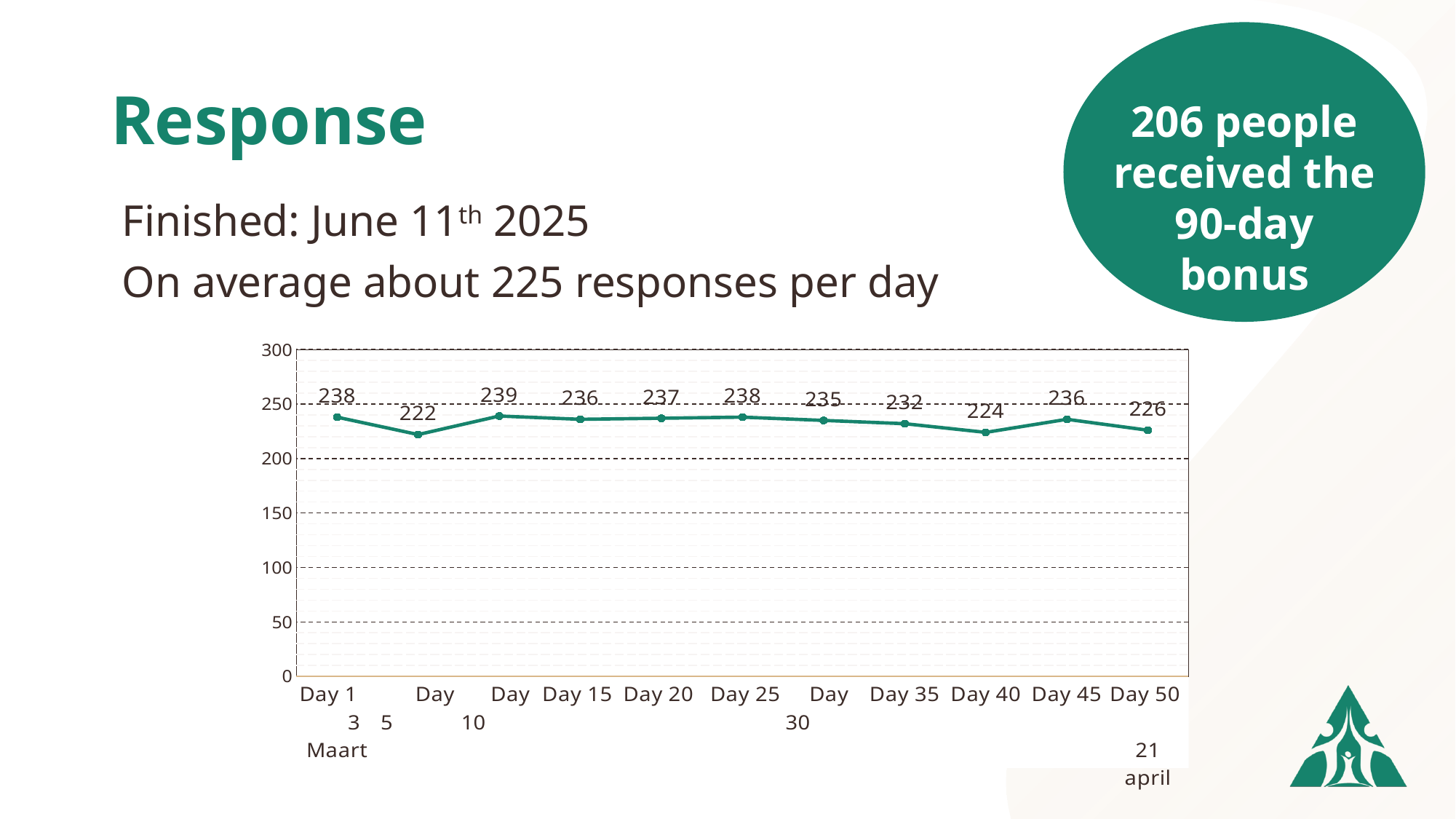
How many data points are plotted on the chart? 11 Which is larger, the value for Day 35 or the value for Day 40? Day 35 What is the difference between the values for Day 10 and Day 5? 17 What type of chart is shown on the slide? line chart What is the value for Day 50? 226 Which day has the lowest value? Day 5 What is the value for Day 1? 238 Is the value for Day 25 greater or less than 200? greater Which day has the highest value? Day 10 What is the difference between the values for Day 1 and Day 50? 12 What is the highest value shown on the y axis? 300 What is the value for Day 40? 224